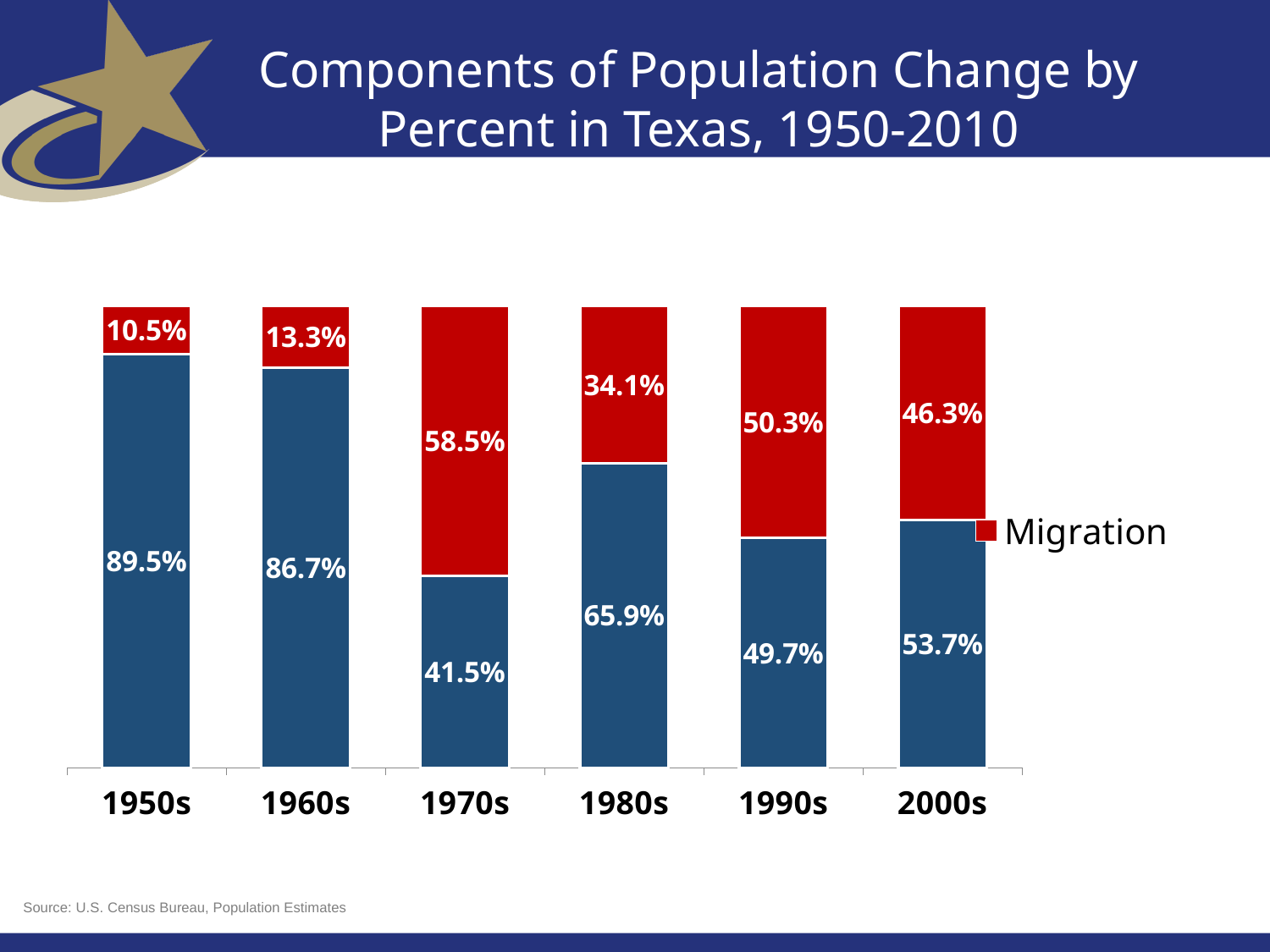
Which decade has the highest Migration value? 1970s What is the total of the two segments in the 1960s bar? 100% Which decade has the lowest Migration value? 1950s What is the difference between the Migration values for the 1990s and the 1980s? 16.2 percentage points How many series does the legend list? 1 What kind of chart is shown on the slide? Stacked bar chart What is the Migration value for the 2000s? 46.3% What is the value of the blue segment for the 1950s bar? 89.5% What is the Migration value for the 1970s? 58.5% How many decades are shown on the x axis? 6 Does the Migration value rise or fall from the 1950s to the 1970s? Rise Which is larger, the Migration value for the 1980s or for the 2000s? 2000s